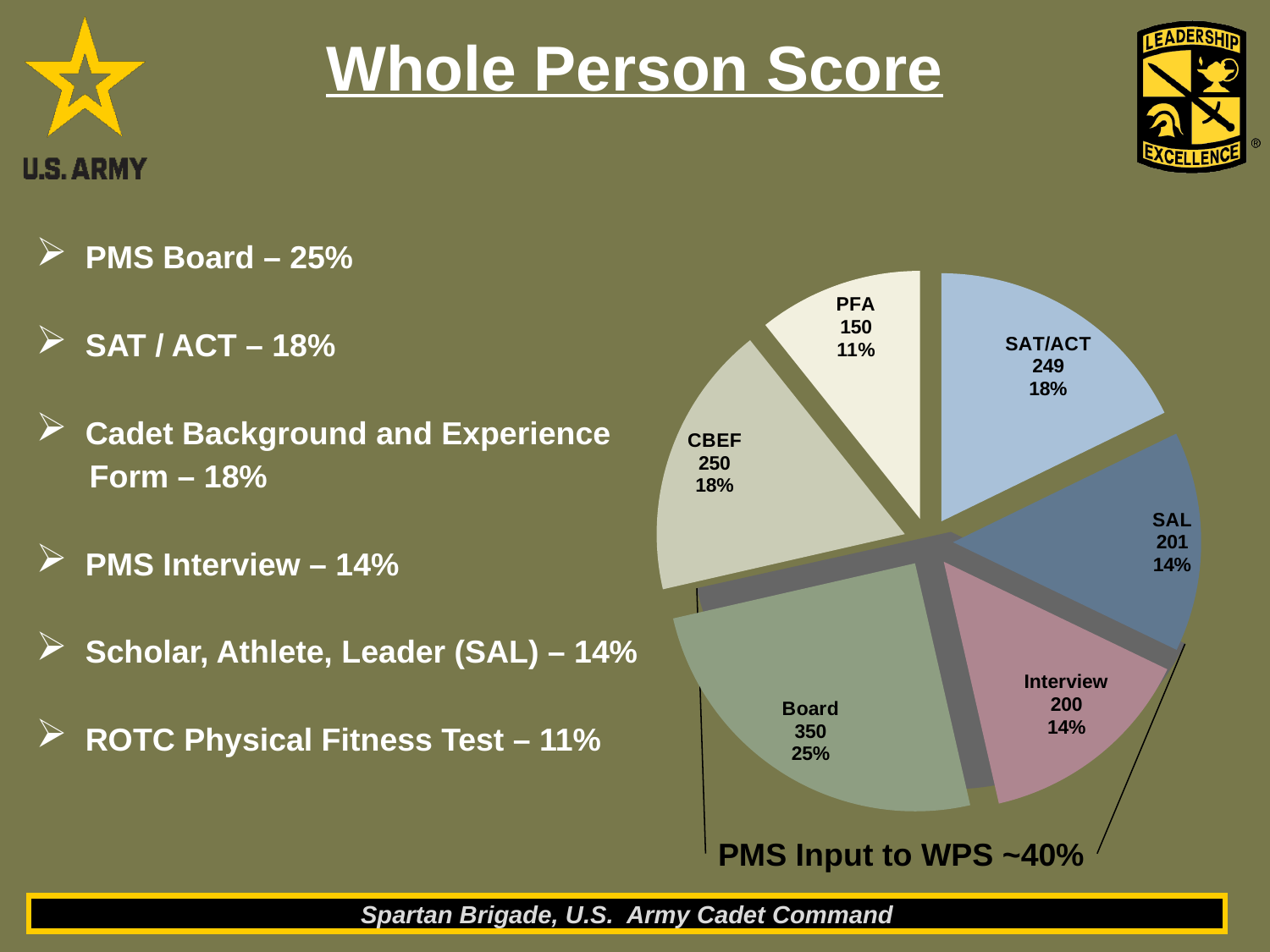
What value is shown for the SAL slice? 201 What annotation is written below the pie chart? PMS Input to WPS ~40% What value is shown for the Board slice? 350 What kind of chart is shown on the slide? pie chart How many slices does the pie chart have? 6 What percentage share does the Board slice have? 25% Which slice has the highest value? Board What percentage share does the PFA slice have? 11% What value is shown for the SAT/ACT slice? 249 Which is larger, the Board slice or the Interview slice? Board What is the difference between the Board value and the PFA value? 200 Which slice has the lowest value? PFA